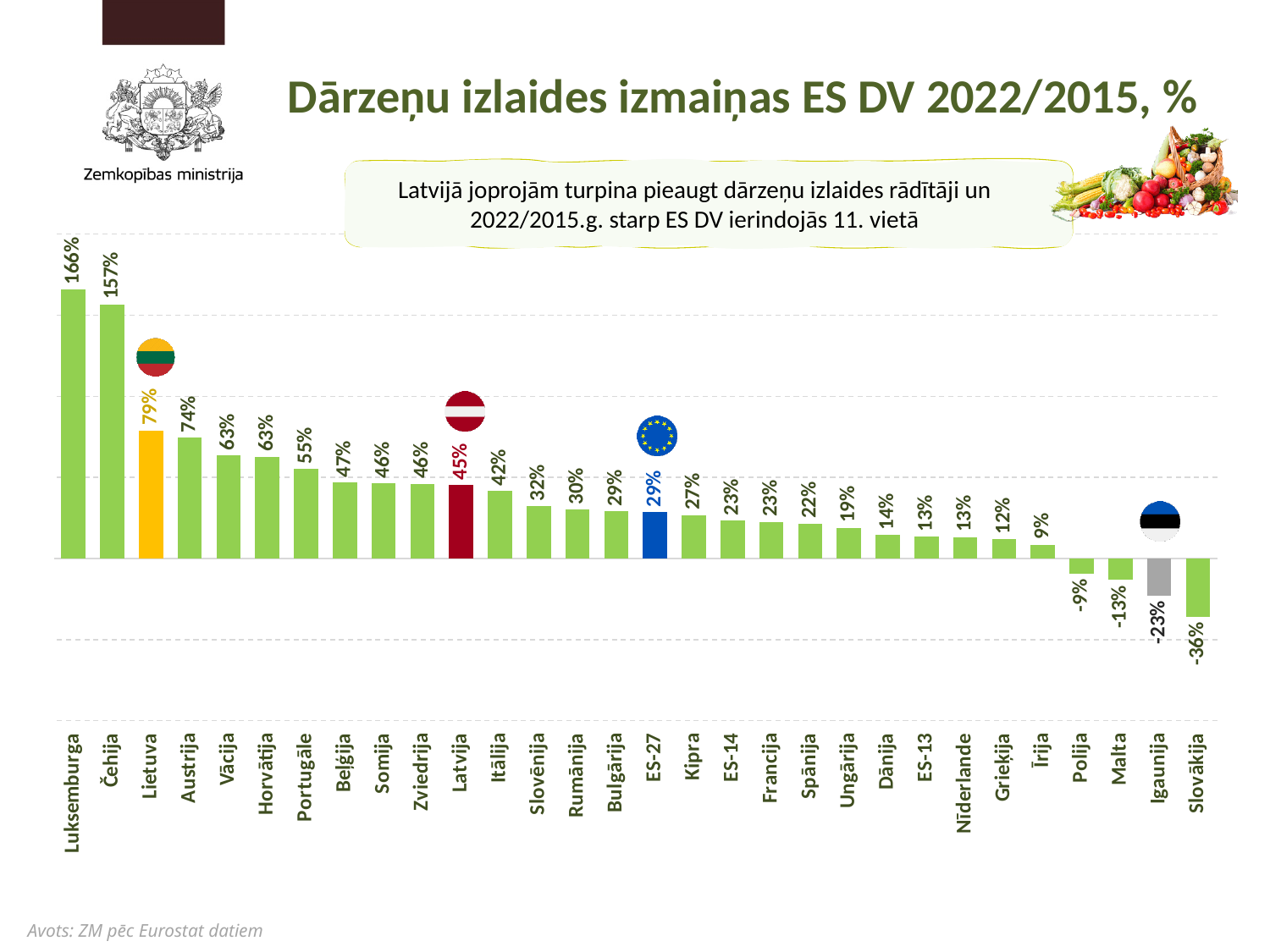
What is the value for ES-27? 29% Which is larger, the value for Austrija or the value for Portugāle? Austrija How many categories have a negative value? 4 What is the difference between the values for Lietuva and Latvija? 34 percentage points What is the value for Lietuva? 79% What is the value for Latvija? 45% What is the difference between the values for Luksemburga and Čehija? 9 percentage points Do the values rise or fall from left to right along the x axis? Fall What kind of chart is shown on the slide? Bar chart Which category has the lowest value? Slovākija Which category has the highest value? Luksemburga How many categories are shown on the chart? 30